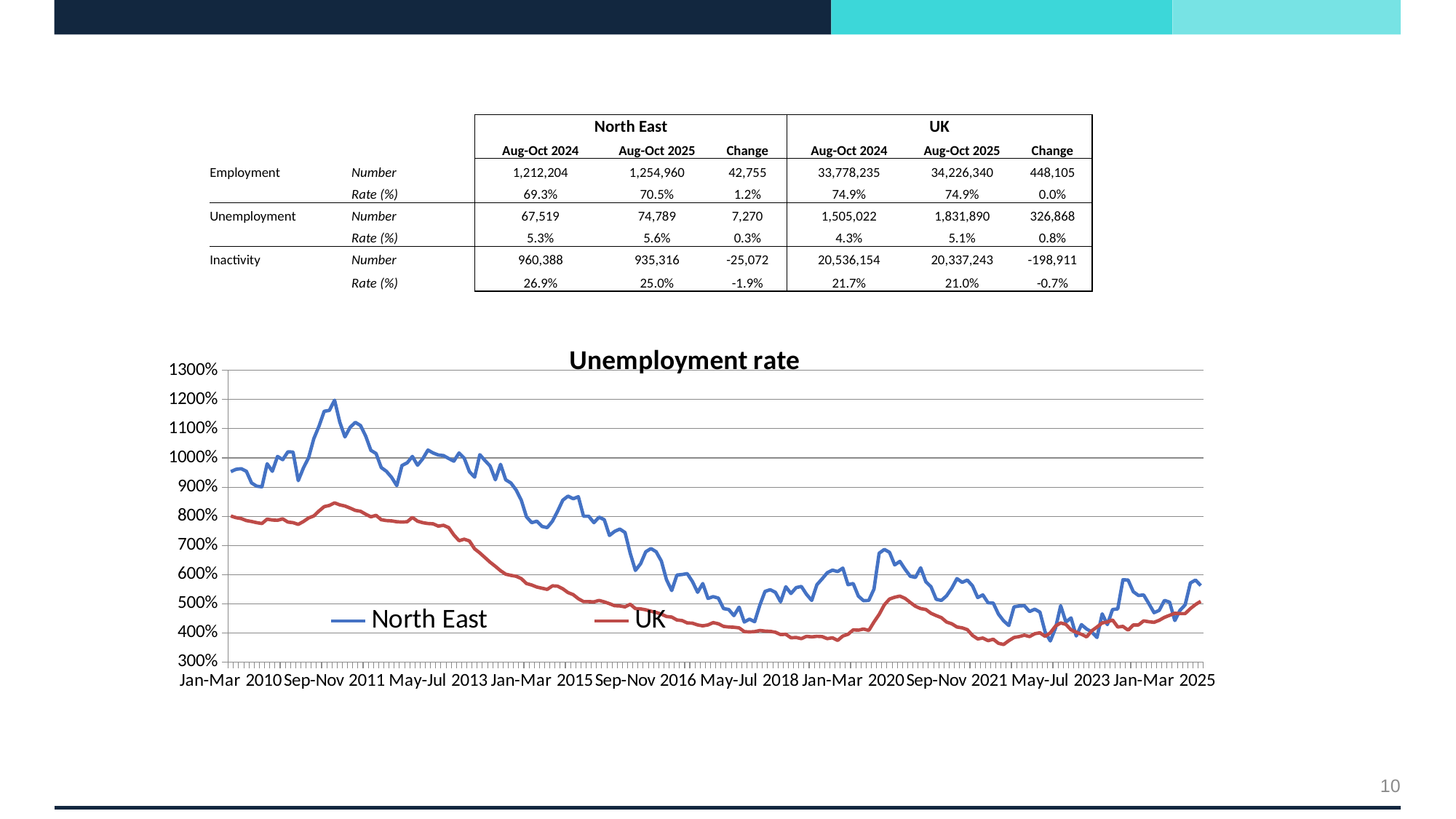
How many series does the legend of the "Unemployment rate" chart list? 2 In the "Unemployment rate" chart, which series reaches the highest value over the whole period? North East In the "Unemployment rate" chart, is the UK value at Jan-Mar 2015 greater or less than 500%? greater In the "Unemployment rate" chart, does the North East line overall rise or fall from Jan-Mar 2010 to Jan-Mar 2025? Fall In the "Unemployment rate" chart, is the highest point of the North East line greater or less than 1100%? greater In the "Unemployment rate" chart, is the UK value at Jan-Mar 2010 greater or less than 900%? less What are the two series shown in the "Unemployment rate" chart? North East and UK What kind of chart is the "Unemployment rate" chart? Line chart In the "Unemployment rate" chart, which series is higher at Jan-Mar 2010, North East or UK? North East In the "Unemployment rate" chart, does the UK line overall rise or fall from Jan-Mar 2010 to Jan-Mar 2025? Fall In the "Unemployment rate" chart, which colour is the UK line? Red